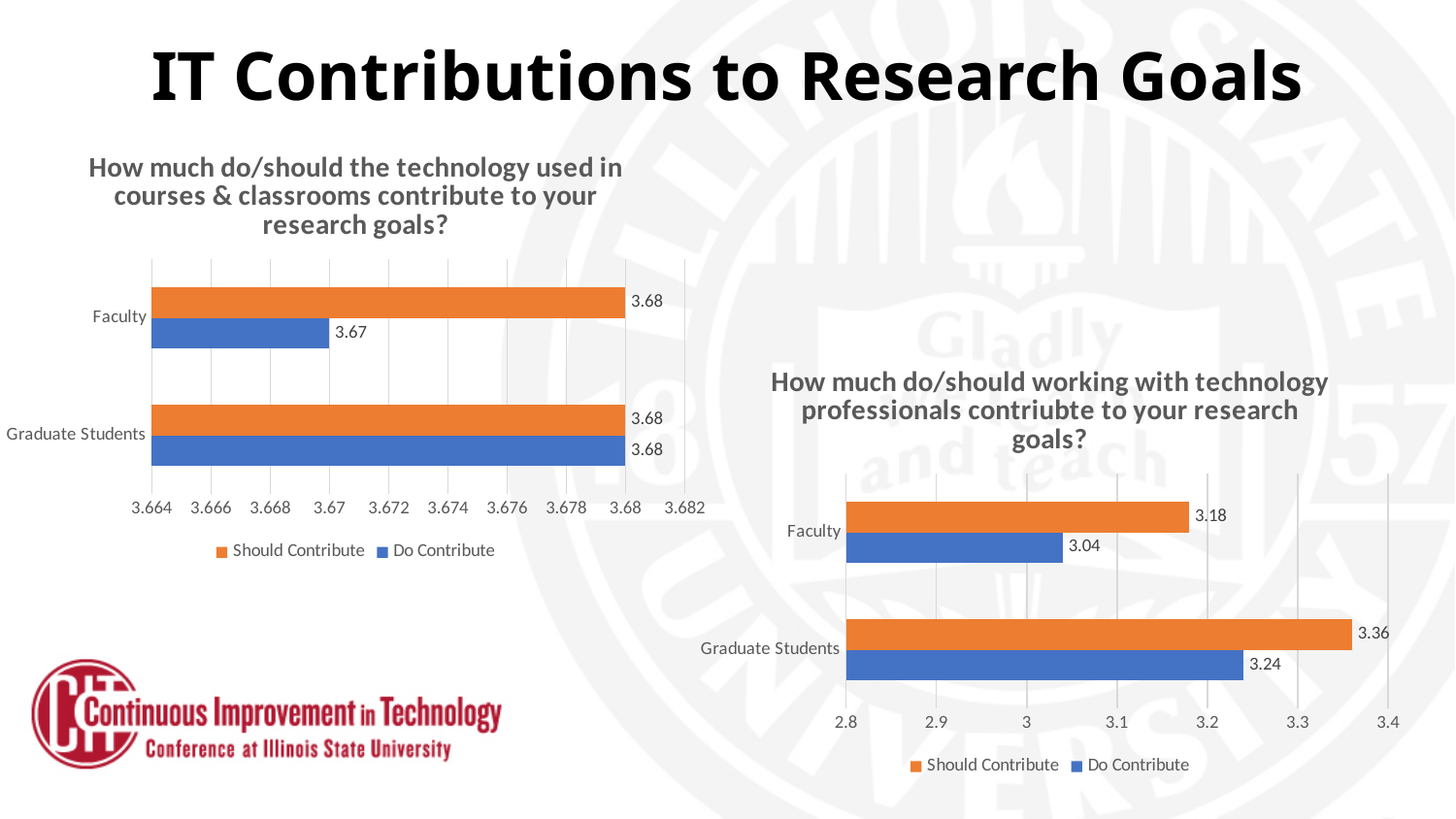
What type of chart is the chart about technology used in courses & classrooms? Bar chart In the chart about technology used in courses & classrooms, what is the 'Do Contribute' value for Faculty? 3.67 In the chart about technology used in courses & classrooms, what is the 'Should Contribute' value for Graduate Students? 3.68 How many series does the legend list in the chart about working with technology professionals? 2 In the chart about working with technology professionals, which group has the lowest 'Do Contribute' value? Faculty In the chart about working with technology professionals, what is the 'Do Contribute' value for Graduate Students? 3.24 In the chart about technology used in courses & classrooms, which is larger for Faculty: 'Should Contribute' or 'Do Contribute'? Should Contribute In the chart about working with technology professionals, what is the 'Should Contribute' value for Faculty? 3.18 In the chart about working with technology professionals, which group has the highest 'Should Contribute' value? Graduate Students In the chart about working with technology professionals, what is the difference between the 'Should Contribute' values for Graduate Students and Faculty? 0.18 In the chart about working with technology professionals, what is the difference between the 'Should Contribute' and 'Do Contribute' values for Faculty? 0.14 In the chart about working with technology professionals, is the 'Do Contribute' value for Faculty greater or less than 3.1? less